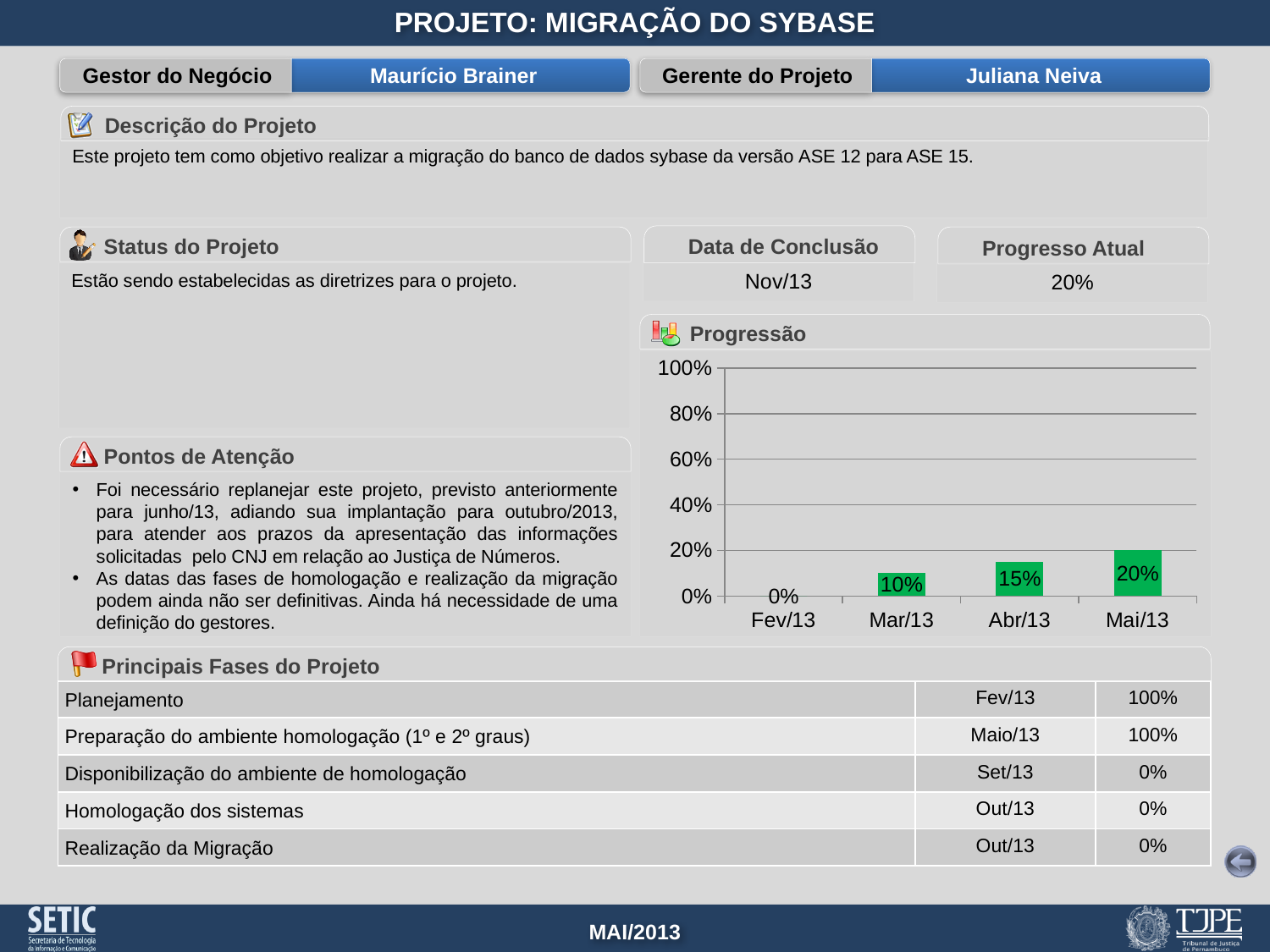
What is the value for Fev/13 in the Progressão chart? 0% What is the value for Mai/13 in the Progressão chart? 20% What is the value for Mar/13 in the Progressão chart? 10% How many months are shown on the x axis of the Progressão chart? 4 What is the difference between the values for Abr/13 and Mar/13 in the Progressão chart? 5% What is the value for Abr/13 in the Progressão chart? 15% What kind of chart is the Progressão chart? Bar chart Which month has the lowest value in the Progressão chart? Fev/13 In the Progressão chart, which is larger: the value for Abr/13 or the value for Mar/13? Abr/13 What is the difference between the values for Mai/13 and Mar/13 in the Progressão chart? 10% Do the values in the Progressão chart rise or fall from Fev/13 to Mai/13? Rise Which month has the highest value in the Progressão chart? Mai/13